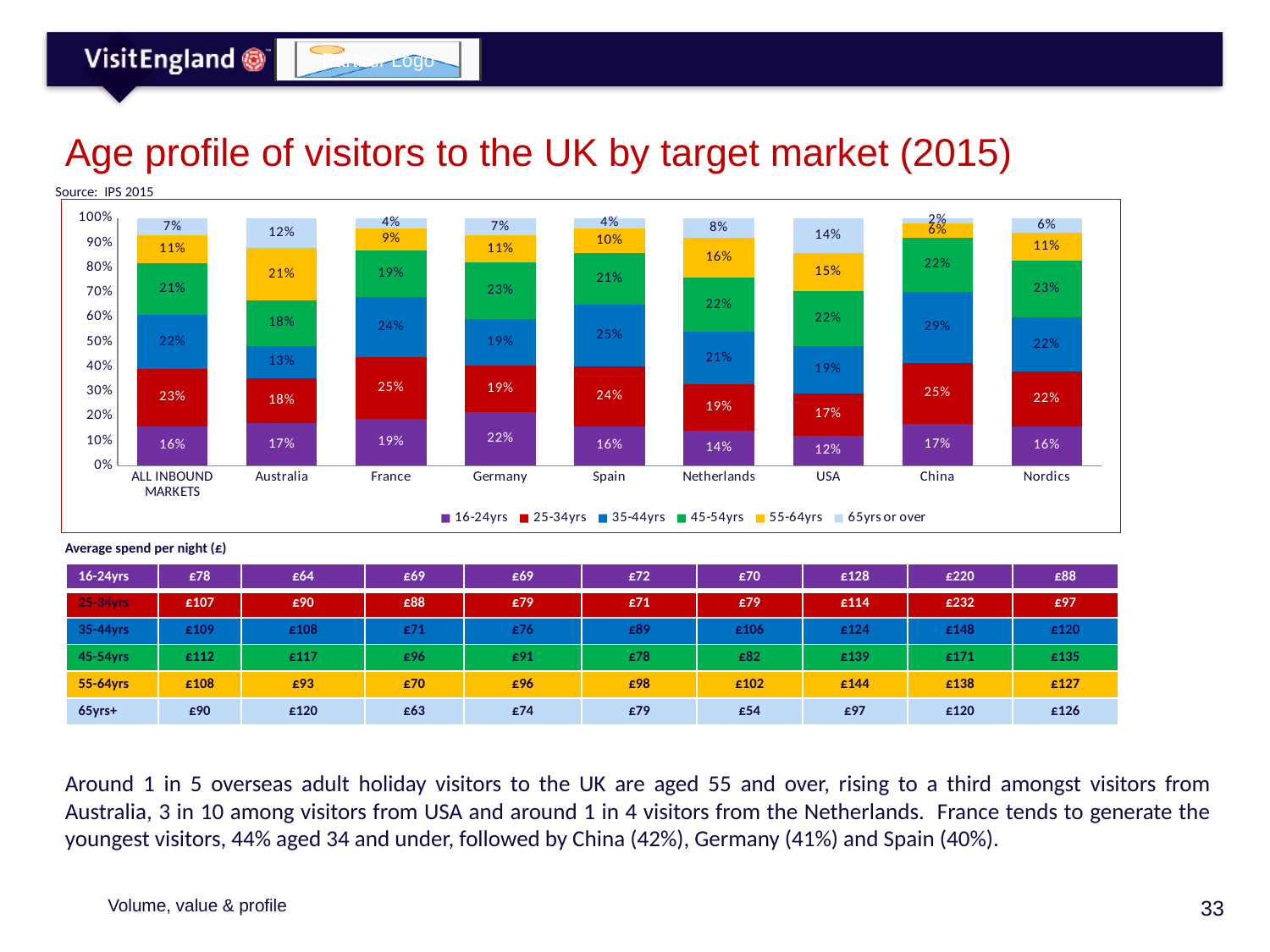
Which market has the lowest share of visitors aged 65yrs or over? China Which has a larger share of visitors aged 25-34yrs, France or the Netherlands? France What percentage of ALL INBOUND MARKETS visitors are aged 25-34yrs? 23% What type of chart is used to show the age profile of visitors? Stacked bar chart What share of visitors from Australia are aged 55-64yrs? 21% How many markets are shown on the x axis of the chart? 9 How many age groups does the chart legend list? 6 What percentage of visitors from the USA are aged 65yrs or over? 14% Which market has the highest share of visitors aged 16-24yrs? Germany How many percentage points higher is the 55-64yrs share for Australia than for France? 12 percentage points What percentage of visitors from China are aged 35-44yrs? 29% Which market has the lowest share of visitors aged 16-24yrs? USA